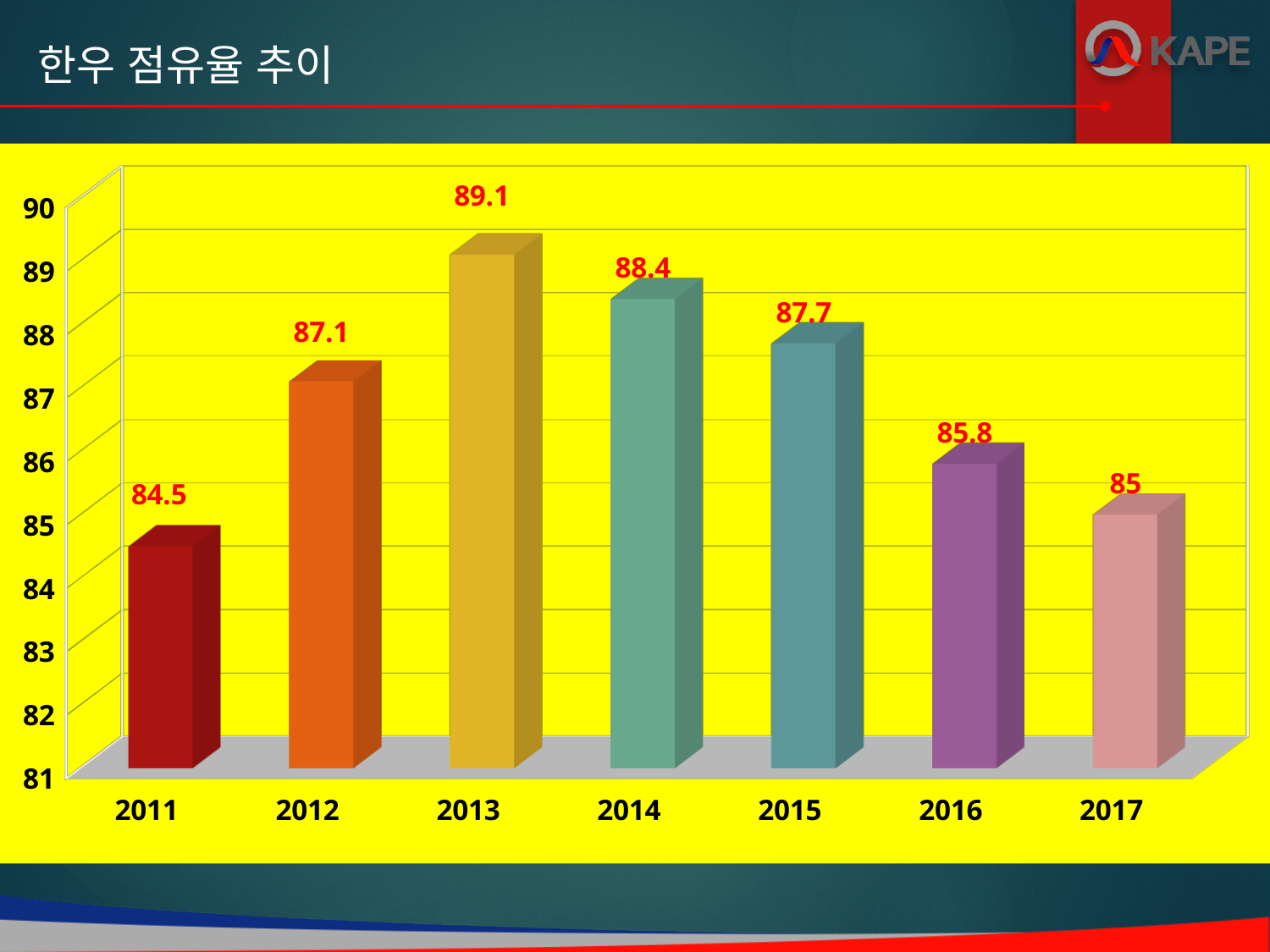
Do the values rise or fall from 2013 to 2017? fall What kind of chart is shown on the slide? bar chart What is the difference between the values for 2014 and 2016? 2.6 Which year has the lowest value? 2011 What is the value for 2011? 84.5 What is the value for 2013? 89.1 What is the difference between the values for 2013 and 2011? 4.6 Which is larger, the value for 2012 or the value for 2016? 2012 What is the value for 2015? 87.7 Which year has the highest value? 2013 How many years are shown on the x axis? 7 What is the value for 2017? 85